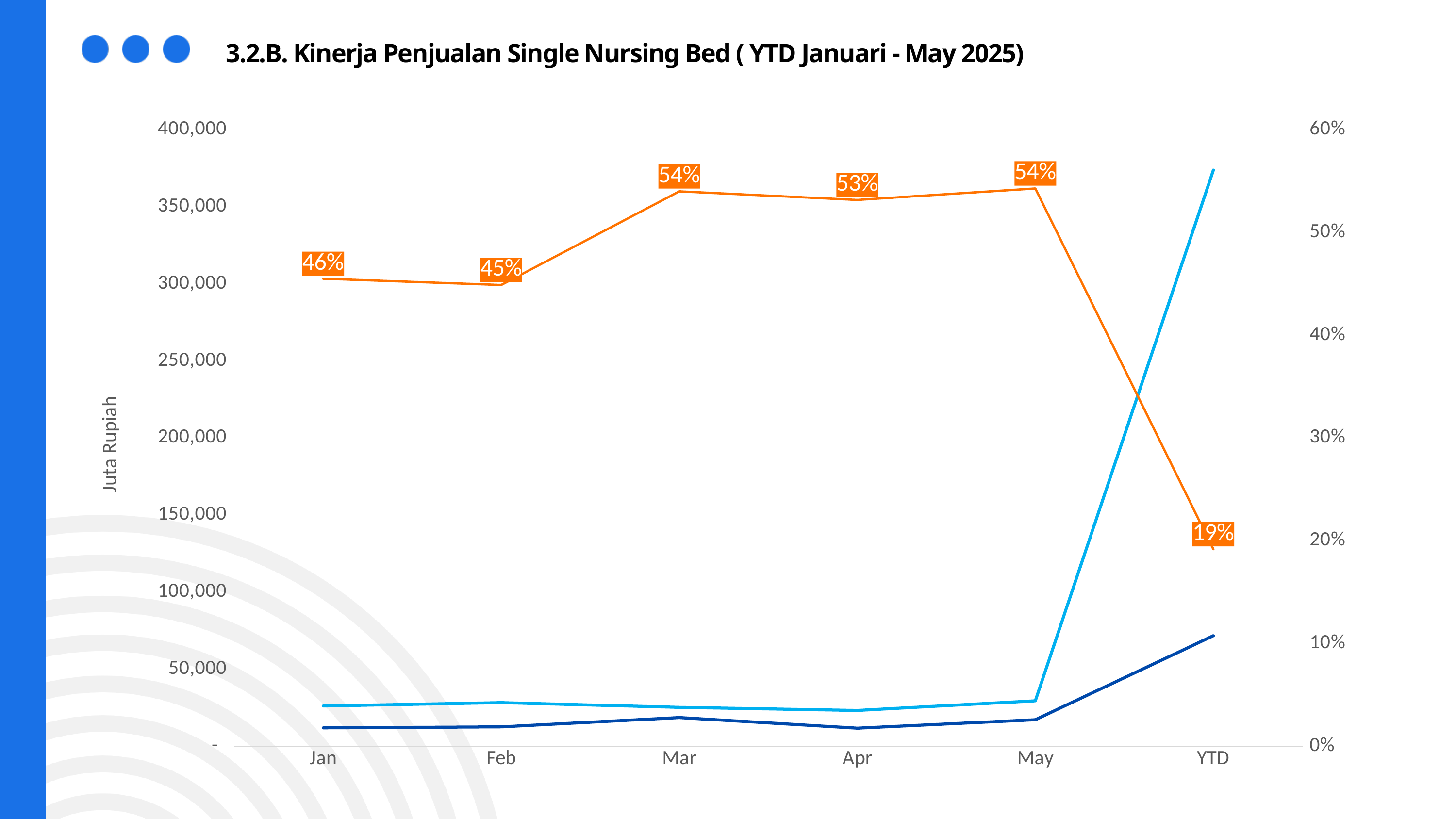
Which category has the lowest percentage on the orange line? YTD What is the percentage value shown for Apr on the orange line? 53% What is the title of the left vertical axis? Juta Rupiah What is the percentage value shown for YTD on the orange line? 19% What is the percentage value shown for Feb on the orange line? 45% What is the percentage value shown for Jan on the orange line? 46% Which has the higher percentage on the orange line, Jan or Feb? Jan What is the difference between the orange line's percentage for Mar and for YTD? 35% What kind of chart is shown on the slide? Line chart Is the dark blue line's value for YTD greater or less than 100,000? less Is the light blue line's value for YTD greater or less than 350,000? greater How many categories are shown on the x axis? 6